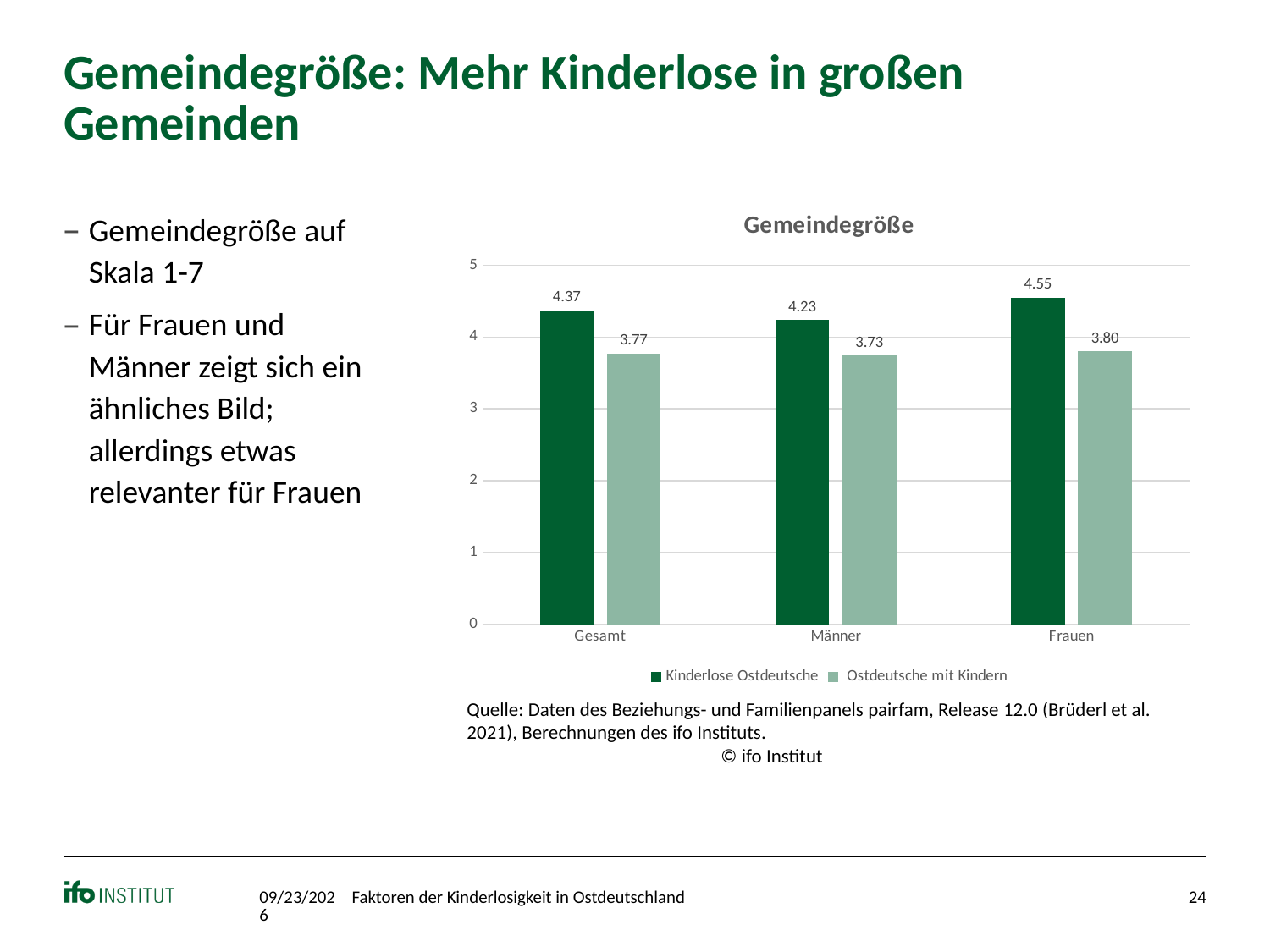
Which category has the highest value for Kinderlose Ostdeutsche? Frauen What is the difference between Kinderlose Ostdeutsche and Ostdeutsche mit Kindern in the Frauen category? 0.75 What is the title of the chart? Gemeindegröße Is the value for Ostdeutsche mit Kindern in the Gesamt category greater or less than 4? less What is the value for Kinderlose Ostdeutsche in the Frauen category? 4.55 Which category has the lowest value for Ostdeutsche mit Kindern? Männer Which is larger in the Männer category: Kinderlose Ostdeutsche or Ostdeutsche mit Kindern? Kinderlose Ostdeutsche What is the value for Kinderlose Ostdeutsche in the Gesamt category? 4.37 What kind of chart is shown on the slide? bar chart How many series does the legend list? 2 How many categories are shown on the x axis? 3 What is the value for Ostdeutsche mit Kindern in the Männer category? 3.73